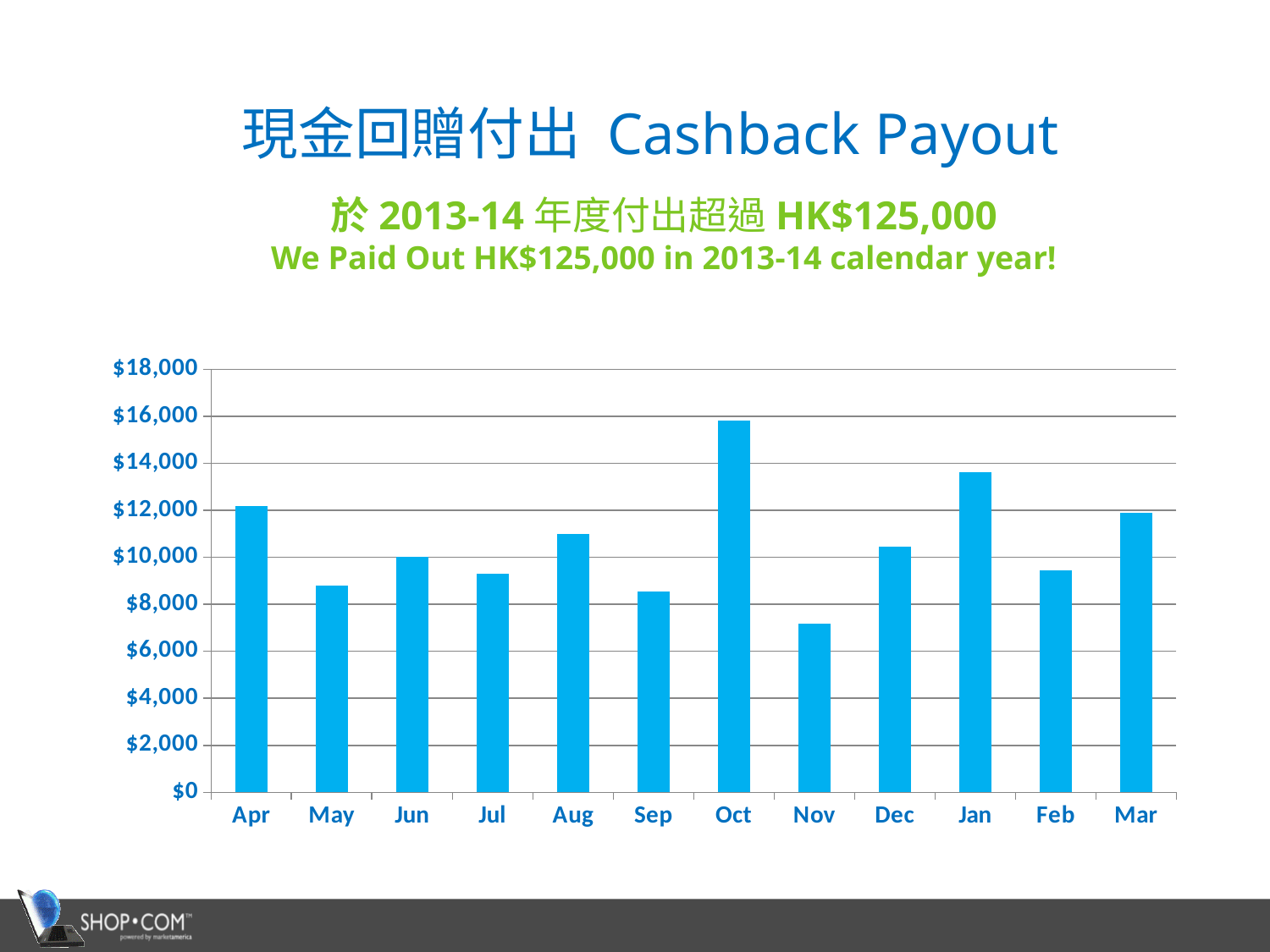
Which month has the highest cashback payout? Oct What kind of chart is shown on the slide? bar chart Is the value for Oct greater or less than $14,000? greater Does the cashback payout rise or fall from Oct to Nov? fall Is the value for Sep greater or less than $10,000? less Which month has a larger cashback payout, Dec or Jan? Jan Which month has a larger cashback payout, Apr or May? Apr Is the value for Nov greater or less than $8,000? less What is the English title of the chart on the slide? Cashback Payout How many months are shown on the x axis of the chart? 12 Which month has the lowest cashback payout? Nov